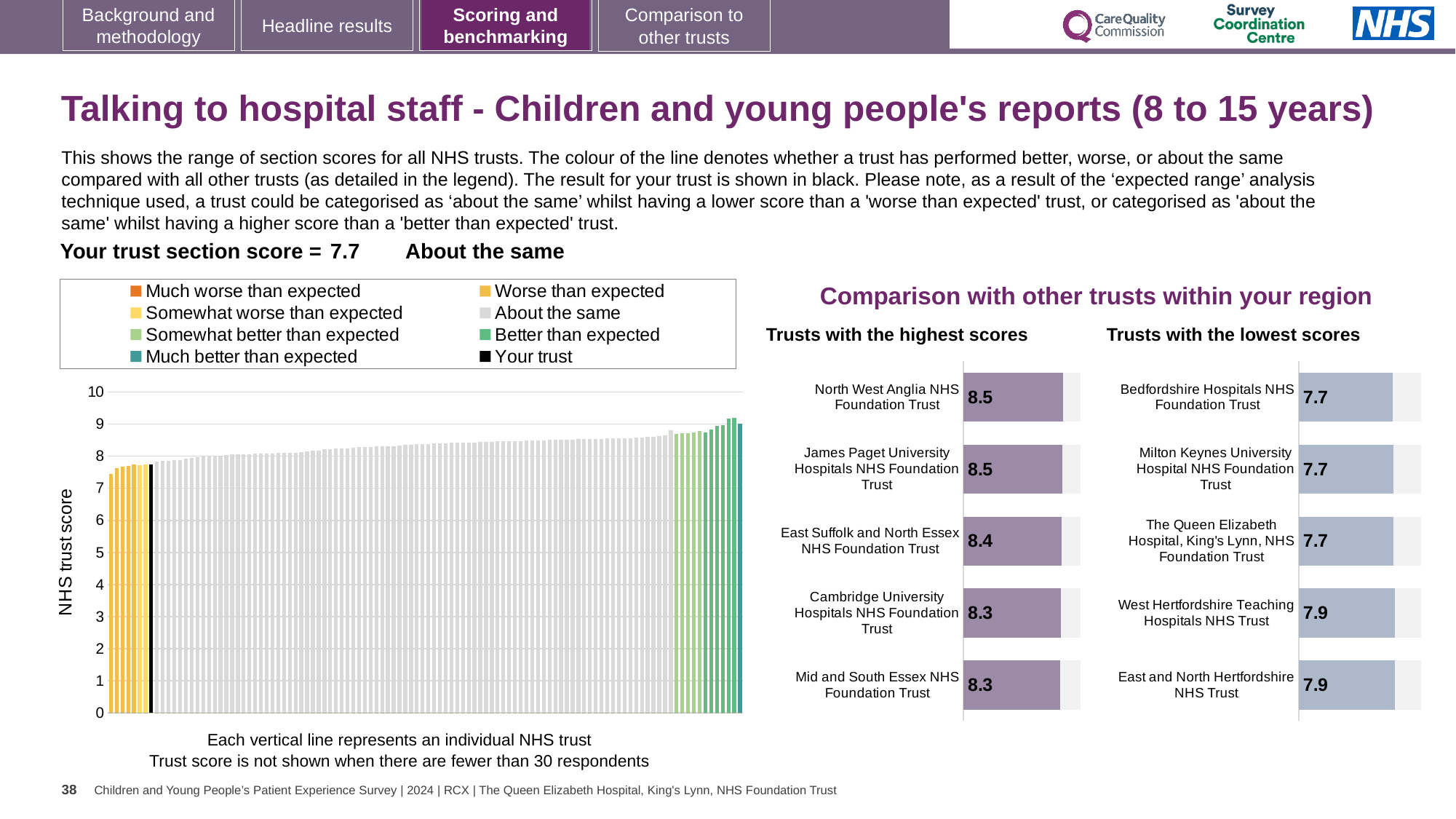
In the 'Trusts with the highest scores' chart, what is the value for North West Anglia NHS Foundation Trust? 8.5 In the 'Trusts with the lowest scores' chart, what is the difference between the values for East and North Hertfordshire NHS Trust and Bedfordshire Hospitals NHS Foundation Trust? 0.2 In the 'Trusts with the highest scores' chart, what is the value for Cambridge University Hospitals NHS Foundation Trust? 8.3 In the 'Trusts with the highest scores' chart, how many trusts are shown? 5 In the 'Trusts with the highest scores' chart, which has the larger value: East Suffolk and North Essex NHS Foundation Trust or Cambridge University Hospitals NHS Foundation Trust? East Suffolk and North Essex NHS Foundation Trust In the 'Trusts with the lowest scores' chart, what is the value for West Hertfordshire Teaching Hospitals NHS Trust? 7.9 In the 'Trusts with the highest scores' chart, what is the difference between the values for North West Anglia NHS Foundation Trust and Mid and South Essex NHS Foundation Trust? 0.2 In the chart on the left with the y axis labelled 'NHS trust score', what kind of chart is it? Bar chart In the chart on the left, do the bar values rise or fall from left to right along the x axis? Rise In the chart on the left, what is the label on the y axis? NHS trust score In the chart on the left, how many entries does the legend list? 8 In the chart on the left, is the value for the black bar (Your trust) greater or less than 8? less